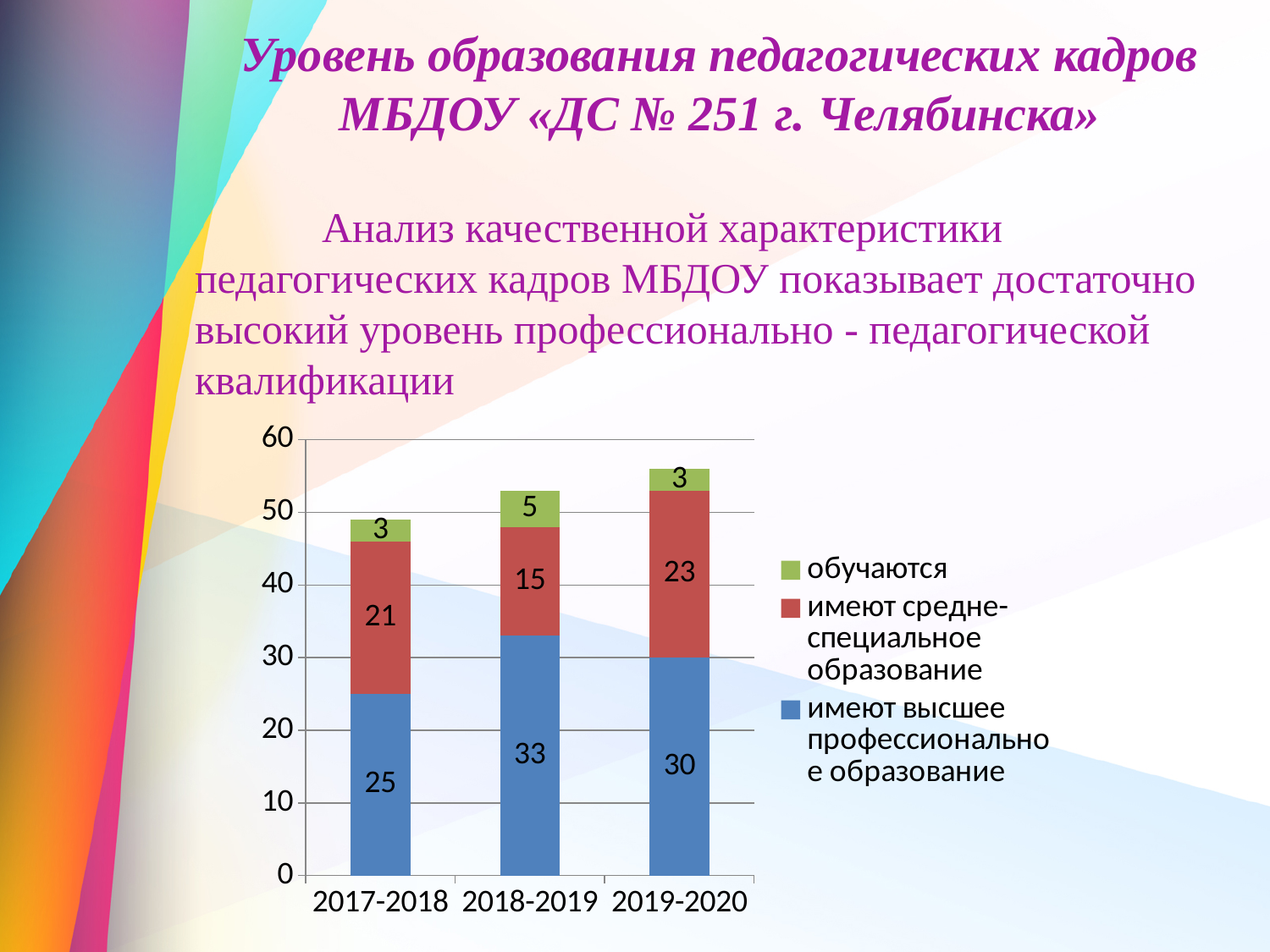
What is the total of the stacked bar for 2019-2020? 56 How many categories (academic years) are shown on the x axis of the chart? 3 In which year is the value for "имеют средне-специальное образование" the lowest? 2018-2019 Which colour represents the series "обучаются" in the chart? green What kind of chart is shown on the slide? stacked bar chart What is the difference between the "имеют высшее профессиональное образование" values for 2018-2019 and 2017-2018? 8 What is the value for "обучаются" in 2018-2019? 5 Which is larger: the "имеют средне-специальное образование" value in 2017-2018 or in 2019-2020? 2019-2020 In which year is the value for "имеют высшее профессиональное образование" the highest? 2018-2019 How many series does the chart legend list? 3 What is the value for "имеют высшее профессиональное образование" in 2018-2019? 33 What is the value for "имеют средне-специальное образование" in 2019-2020? 23